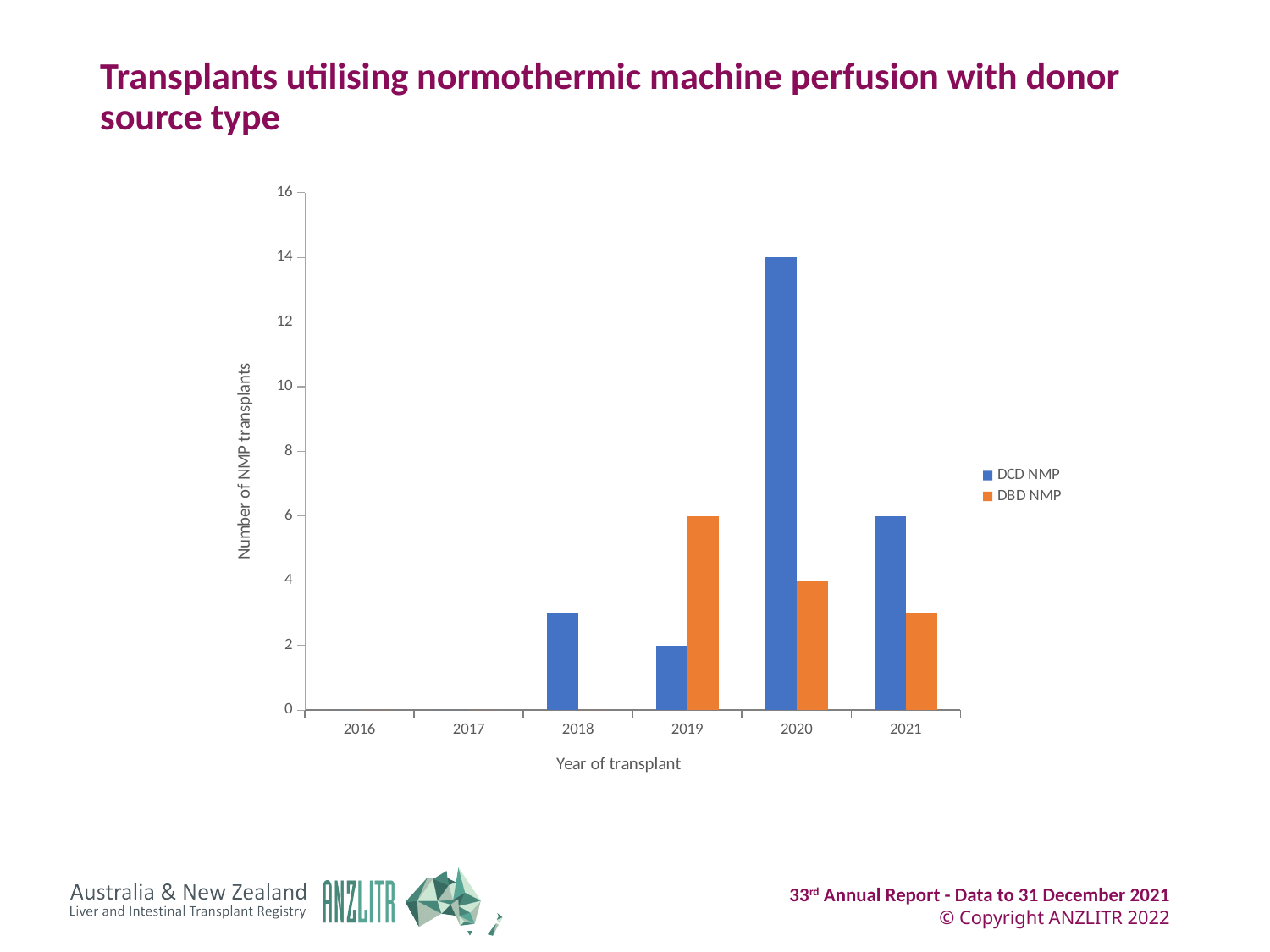
How many years are shown on the x axis? 6 What is the value for DCD NMP in 2021? 6 What is the value for DCD NMP in 2020? 14 What kind of chart is shown on the slide? bar chart Is the value for DBD NMP in 2021 greater or less than 2? greater What is the difference between DCD NMP and DBD NMP in 2020? 10 Which year has the highest DCD NMP value? 2020 Is the value for DCD NMP in 2018 greater or less than 4? less What is the value for DBD NMP in 2019? 6 What is the value for DBD NMP in 2020? 4 In 2019, which is larger: DCD NMP or DBD NMP? DBD NMP How many series does the legend list? 2